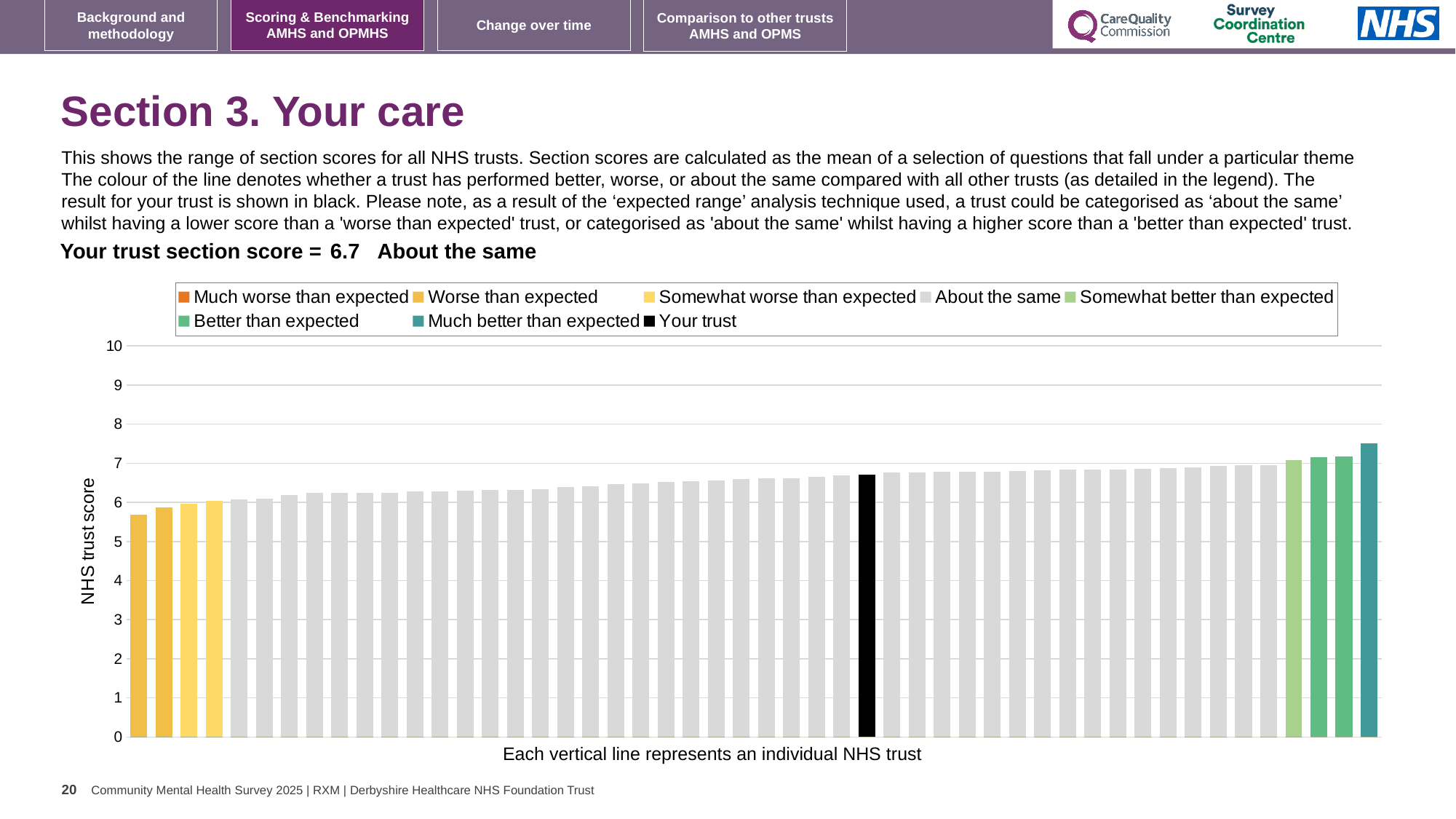
What kind of chart is shown on the slide? bar chart Is the value for your trust greater or less than 6? greater Do the bar values rise or fall from left to right along the x axis? rise How many trusts are shown in the 'Much better than expected' category? 1 Which category is your trust placed in for this section? About the same Which legend category does the highest bar belong to? Much better than expected What is the title of the vertical axis? NHS trust score Is the value for your trust greater or less than 7? less Is the value of the lowest bar greater or less than 6? less What is the section score for your trust shown on the slide? 6.7 How many entries does the chart legend list? 8